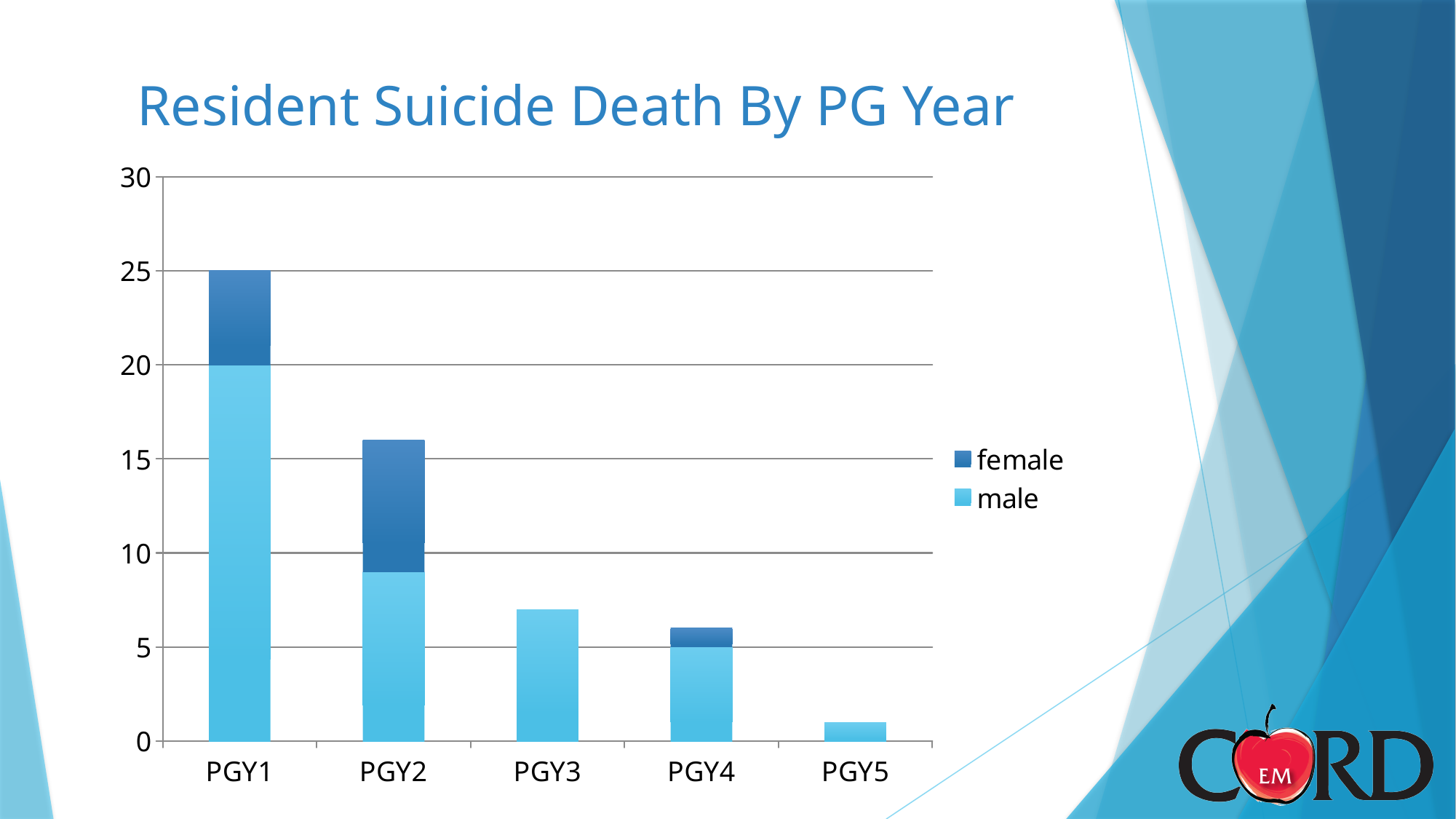
Which has a larger total, PGY2 or PGY3? PGY2 What is the total height of the stacked bar for PGY1? 25 Is the total value for PGY2 greater or less than 15? greater What is the male value for PGY4? 5 Do the total values rise or fall from PGY1 to PGY5? fall What kind of chart is shown on the slide? Stacked bar chart Is the value for PGY3 greater or less than 10? less Which PG year has the highest total number of resident suicide deaths? PGY1 How many PG year categories are shown on the x axis? 5 What is the male value for PGY1? 20 Which PG year has the lowest total number of resident suicide deaths? PGY5 How many series does the legend list? 2